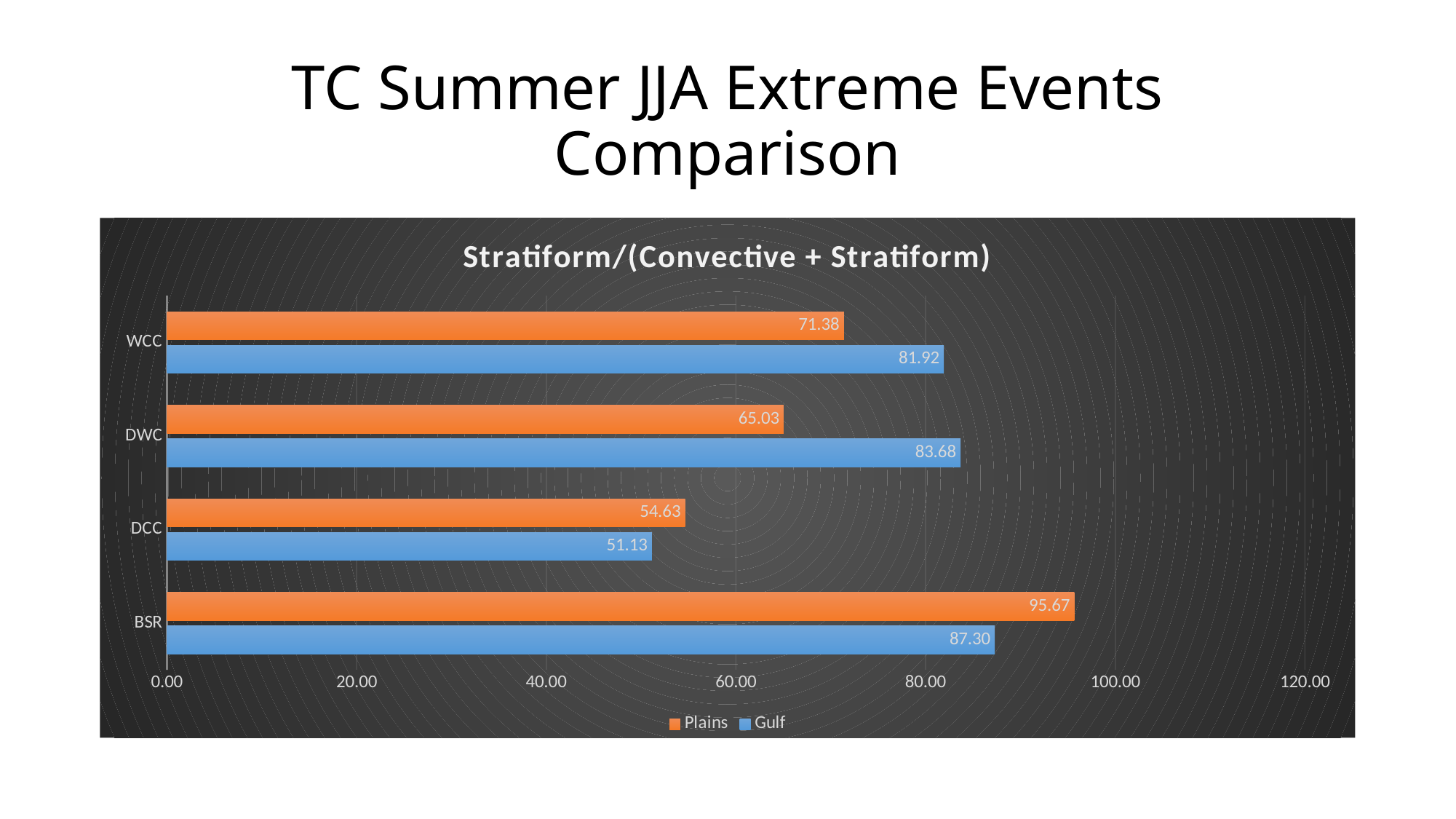
What is the Plains value for WCC? 71.38 Which category has the lowest Gulf value? DCC How many series does the legend list? 2 What is the title of the chart? Stratiform/(Convective + Stratiform) What kind of chart is shown on the slide? bar chart Is the Plains value for DCC greater or less than 60.00? less What is the Gulf value for DCC? 51.13 What is the Gulf value for DWC? 83.68 Which category has the highest Plains value? BSR What is the difference between the Plains and Gulf values for BSR? 8.37 How many categories are shown on the chart? 4 For DWC, which is larger, the Plains value or the Gulf value? Gulf